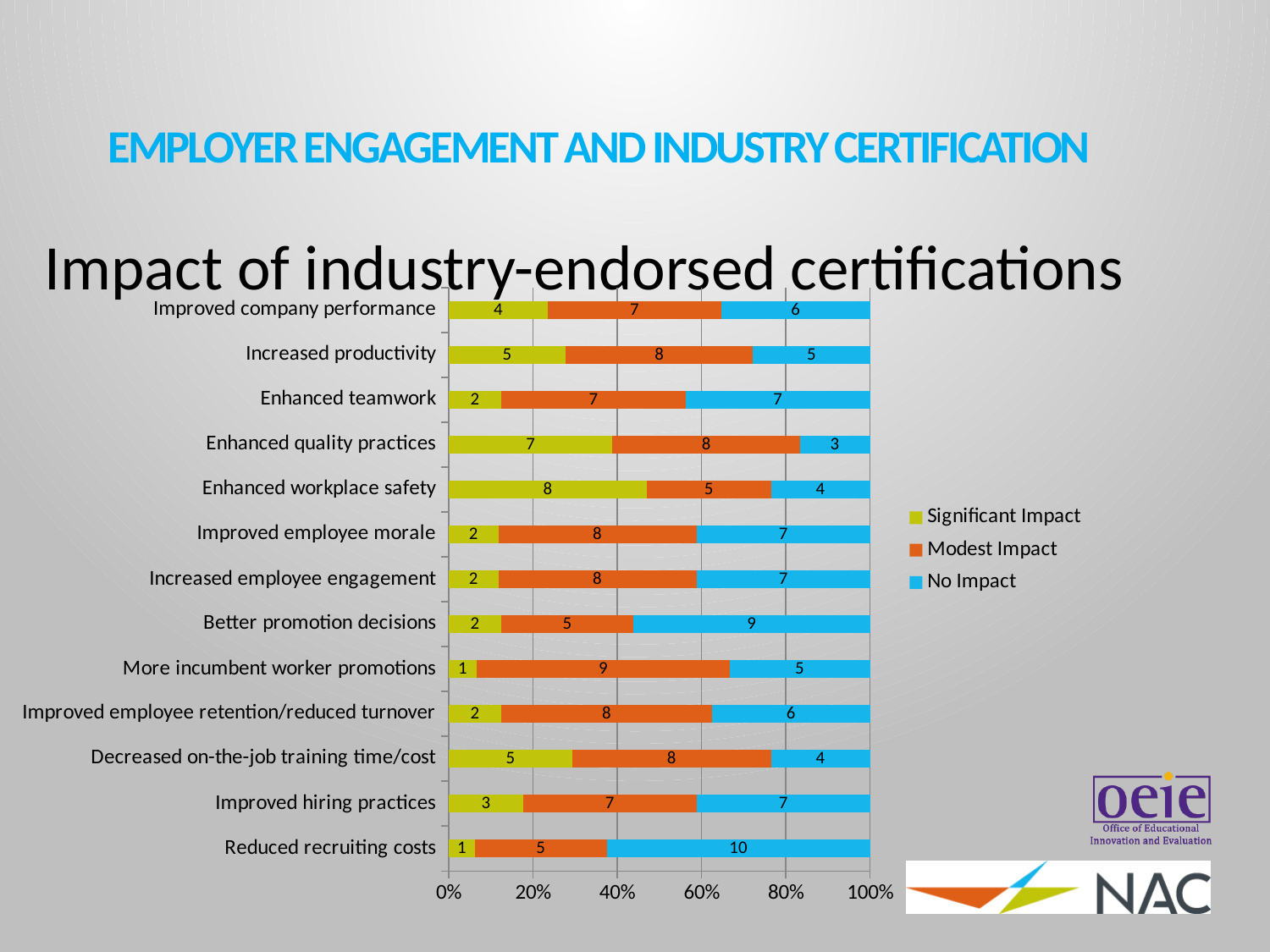
What is the Significant Impact value for Enhanced workplace safety? 8 Which category has the highest Significant Impact value? Enhanced workplace safety What is the Modest Impact value for More incumbent worker promotions? 9 How many categories are shown on the chart? 13 Which is larger: the Significant Impact value for Enhanced quality practices or the Significant Impact value for Improved company performance? Enhanced quality practices Which category has the lowest No Impact value? Enhanced quality practices What is the title of the chart? Impact of industry-endorsed certifications What is the No Impact value for Reduced recruiting costs? 10 What is the difference between the No Impact value for Reduced recruiting costs and the No Impact value for Enhanced quality practices? 7 How many series does the legend list? 3 What kind of chart is shown on the slide? Stacked bar chart What is the total number of responses for Reduced recruiting costs (sum of all three segments)? 16